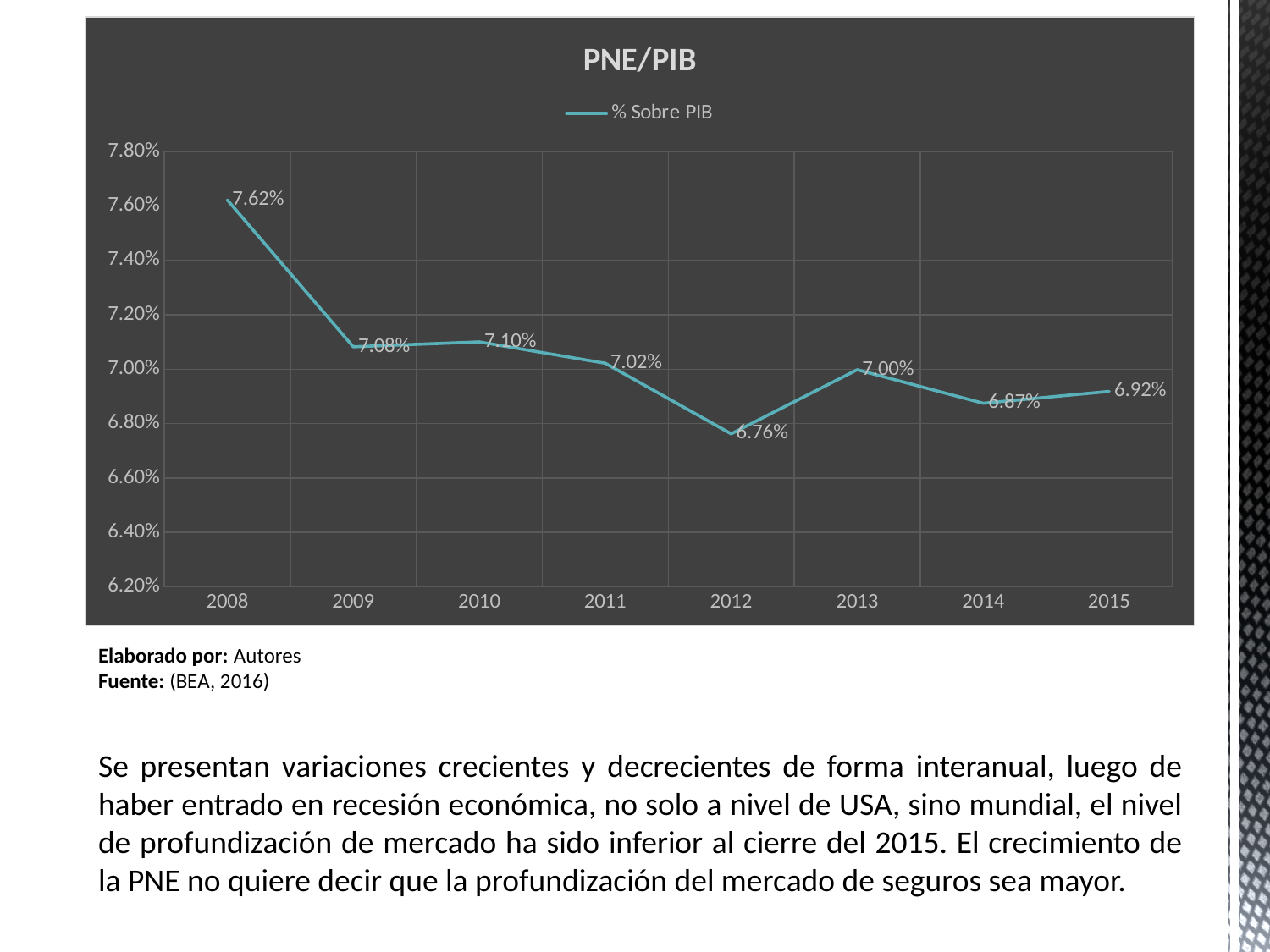
Which year has the highest value? 2008 Which is larger, the value for 2013 or the value for 2014? 2013 What is the value for 2015? 6.92% What is the difference between the values for 2008 and 2015? 0.70% What is the title of the chart? PNE/PIB How many years are plotted on the chart? 8 Which year has the lowest value? 2012 What is the value for 2012? 6.76% What kind of chart is shown? line chart What is the value for 2008? 7.62% Is the value for 2011 greater or less than 7.20%? less How many series does the legend list? 1